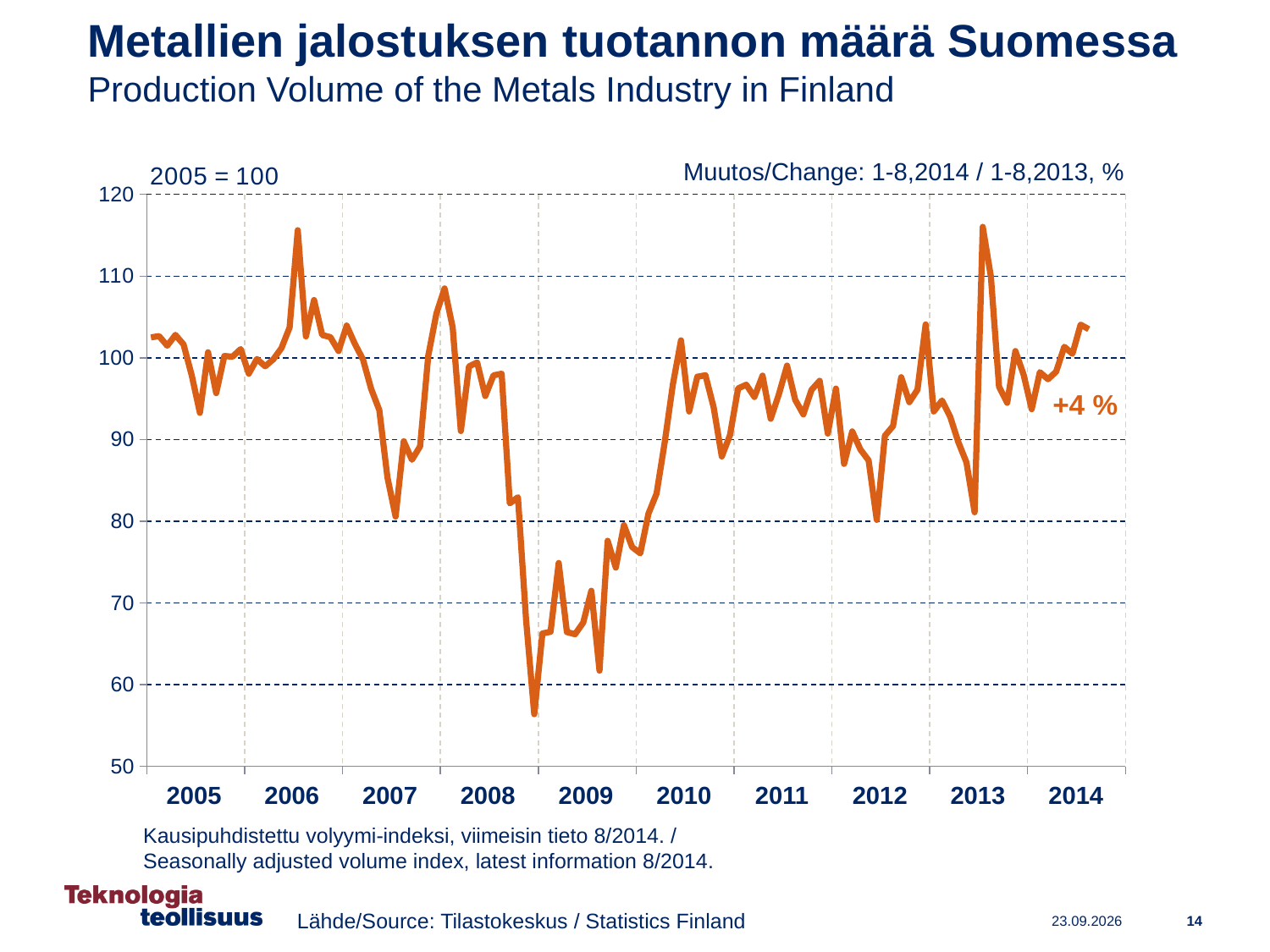
What is the percentage change shown for 1-8,2014 compared with 1-8,2013? +4 % Is the latest value of the index in 2014 greater or less than 100? greater Is the peak value of the index in 2006 greater or less than 110? greater How many years are labelled on the x axis? 10 Is the lowest value of the index, reached in 2009, greater or less than 60? less What kind of chart is shown on the slide? line chart Which year is used as the base year with an index value of 100? 2005 Does the index rise or fall between the start of 2009 and the start of 2010? rise What is the source of the data shown in the chart? Tilastokeskus / Statistics Finland